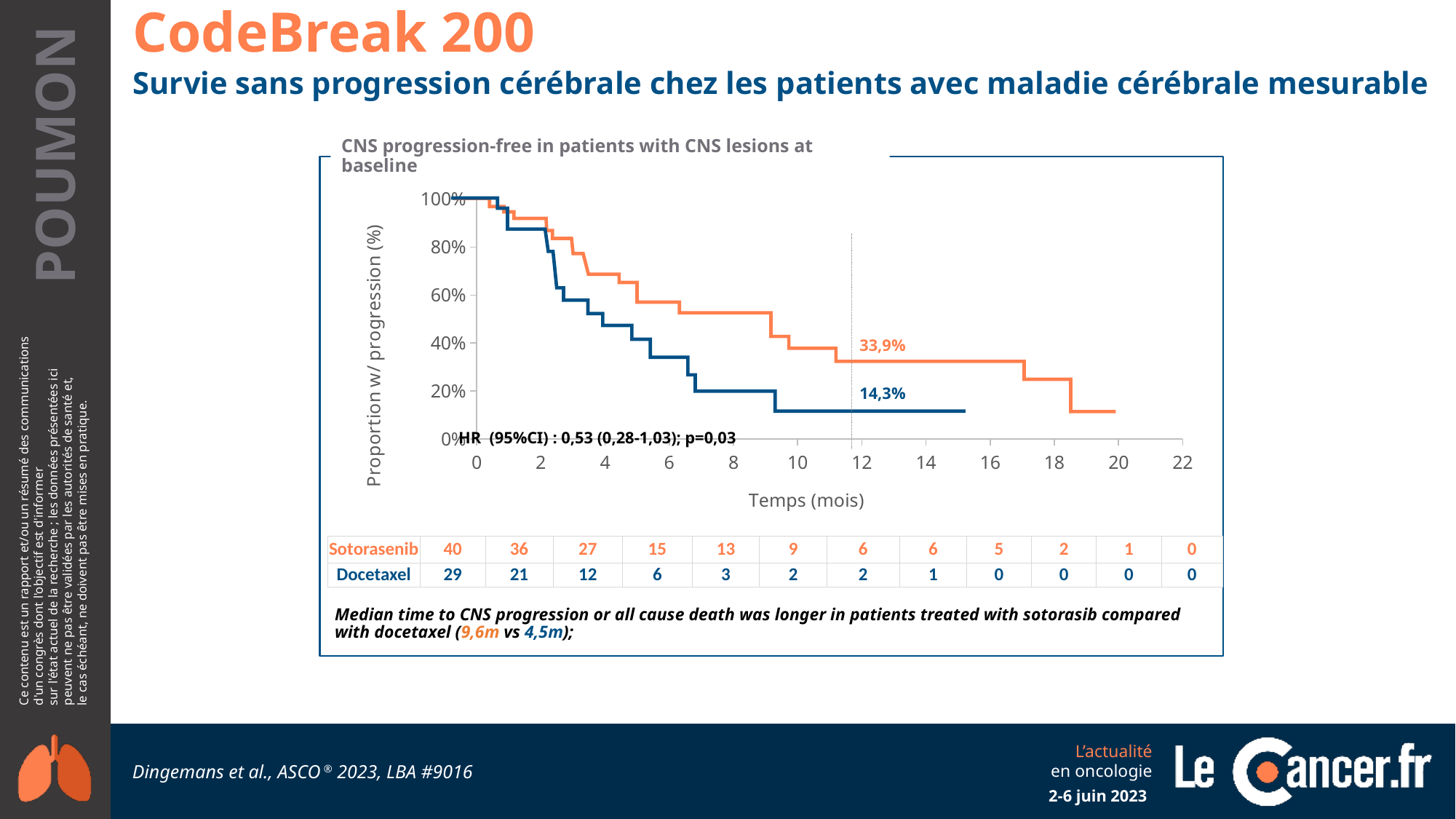
What is the difference between the labelled proportions for Sotorasenib (33,9%) and Docetaxel (14,3%)? 19,6 percentage points How many series (treatment arms) are plotted on the chart? 2 What hazard ratio is printed on the chart? 0,53 (0,28-1,03); p=0,03 Which arm has the higher labelled proportion at the dotted vertical line, Sotorasenib or Docetaxel? Sotorasenib Is the Docetaxel curve at 8 months greater or less than 40%? less Is the Sotorasenib curve at 8 months greater or less than 40%? greater What is the labelled CNS progression-free proportion for Docetaxel at the dotted vertical line? 14,3% In the number-at-risk table, how many Docetaxel patients are at risk at time 0? 29 In the number-at-risk table, how many Sotorasenib patients are at risk at time 0? 40 Do the curves rise or fall as time (months) increases? fall What is the labelled CNS progression-free proportion for Sotorasenib at the dotted vertical line? 33,9% What kind of chart is shown on the slide? line chart